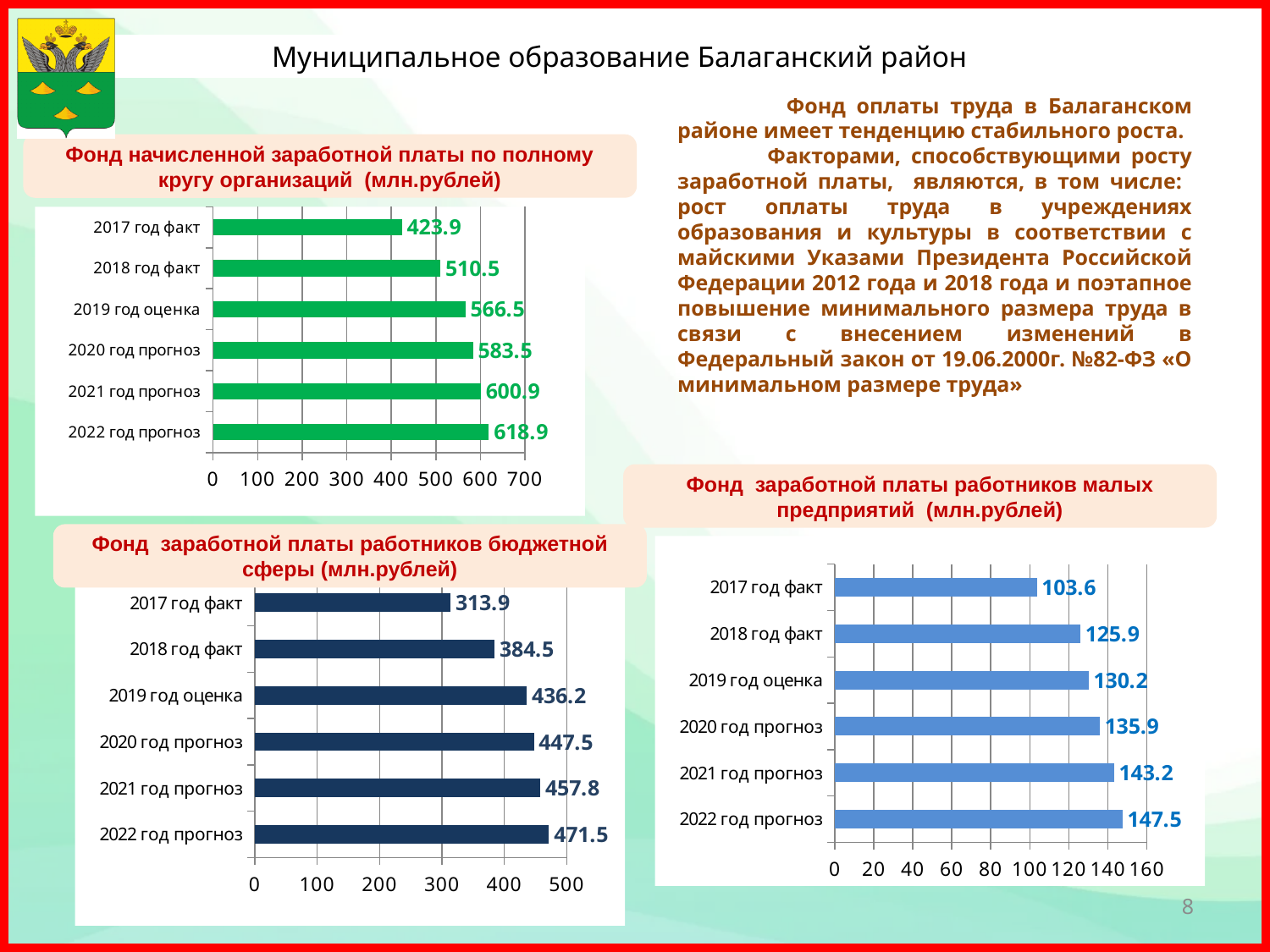
In the chart 'Фонд заработной платы работников бюджетной сферы', how many categories are plotted? 6 In the chart 'Фонд заработной платы работников бюджетной сферы', what is the difference between the 2018 год факт and 2017 год факт values? 70.6 In the chart 'Фонд заработной платы работников бюджетной сферы', which category has the highest value? 2022 год прогноз In the chart 'Фонд начисленной заработной платы по полному кругу организаций', what is the difference between the 2022 год прогноз and 2017 год факт values? 195.0 In the chart 'Фонд начисленной заработной платы по полному кругу организаций', what is the value for 2019 год оценка? 566.5 In the chart 'Фонд начисленной заработной платы по полному кругу организаций', which category has the lowest value? 2017 год факт In the chart 'Фонд начисленной заработной платы по полному кругу организаций', do the values rise or fall from 2017 to 2022? rise How many charts are shown on the slide? 3 What kind of chart is 'Фонд заработной платы работников малых предприятий'? bar chart In the chart 'Фонд заработной платы работников малых предприятий', which is larger: the value for 2018 год факт or 2019 год оценка? 2019 год оценка In the chart 'Фонд заработной платы работников бюджетной сферы', what is the value for 2020 год прогноз? 447.5 In the chart 'Фонд заработной платы работников малых предприятий', what is the value for 2021 год прогноз? 143.2